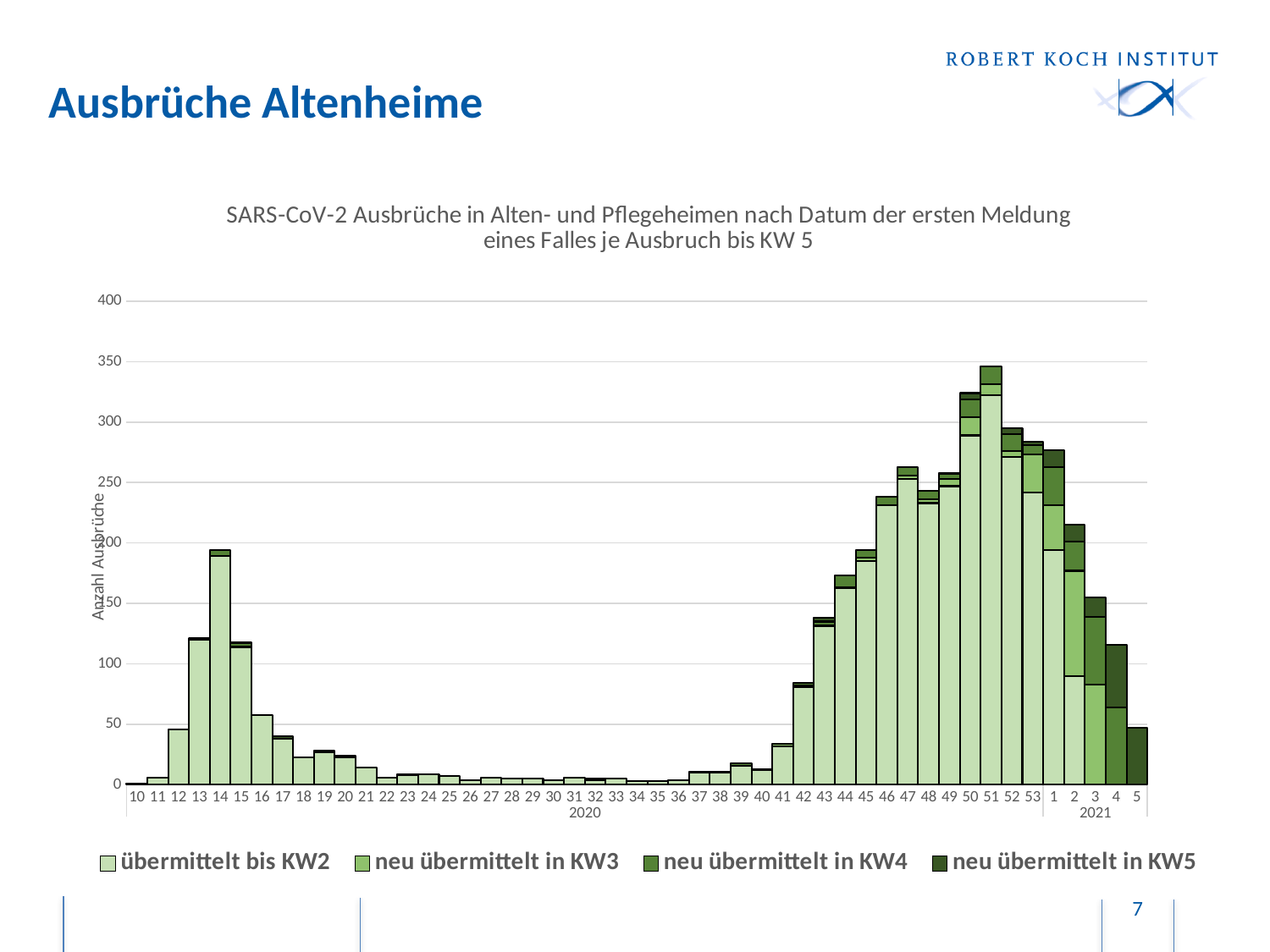
Is the total value for KW 14 of 2020 greater or less than 150? greater Which calendar week has the highest total number of outbreaks? KW 51 (2020) What is the label of the y axis? Anzahl Ausbrüche Is the total value for KW 30 of 2020 greater or less than 50? less Which has the larger total, KW 1 or KW 2 of 2021? KW 1 What kind of chart is shown on the slide? Stacked bar chart Is the total value for KW 51 of 2020 greater or less than 300? greater How many calendar weeks (bars) are plotted along the x axis? 49 How many series does the legend list? 4 Which has the larger total, KW 13 or KW 14 of 2020? KW 14 Do the totals rise or fall from KW 41 to KW 51 of 2020? rise